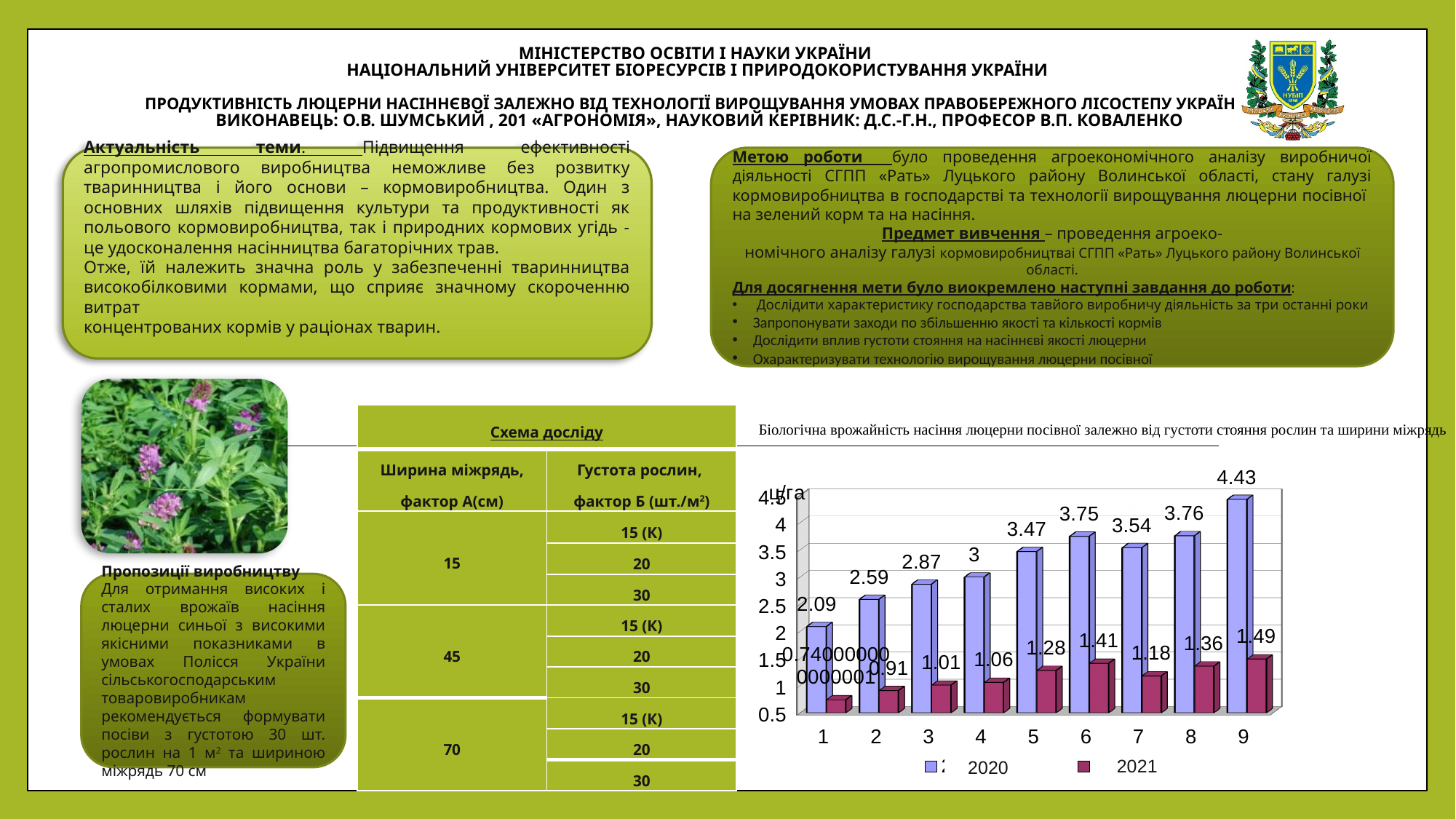
What is the value for category 9 in the 2020 series? 4.43 How many series does the chart legend list? 2 What is the value for category 3 in the 2021 series? 1.01 How many categories are shown along the x axis of the chart? 9 What is the value for category 5 in the 2020 series? 3.47 What unit is shown on the vertical axis of the chart? ц/га What is the difference between the 2020 values for category 9 and category 1? 2.34 Is the 2021 value for category 1 greater or less than 1? less Which category has the highest value in the 2020 series? 9 Which category has the lowest value in the 2021 series? 1 Which is larger in the 2021 series: the value for category 6 or category 7? category 6 What type of chart is shown on the slide? bar chart